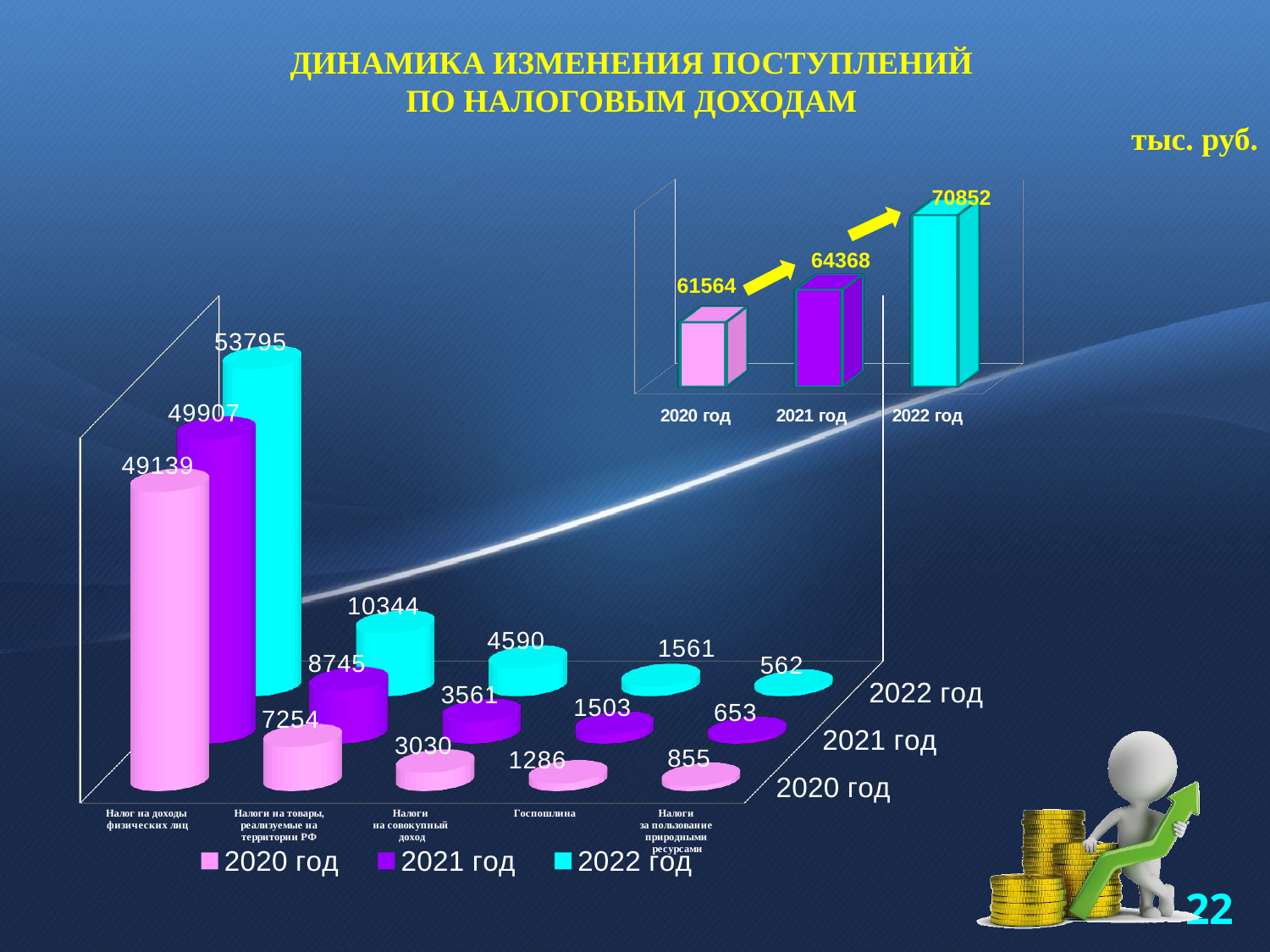
In the large chart at the bottom left of the slide, do the values for Налоги за пользование природными ресурсами rise or fall from 2020 год to 2022 год? fall In the large chart at the bottom left of the slide, which category has the lowest 2022 год value? Налоги за пользование природными ресурсами In the large chart at the bottom left of the slide, how many series does the legend list? 3 In the large chart at the bottom left of the slide, what is the 2020 год value for Госпошлина? 1286 In the large chart at the bottom left of the slide, what is the difference between the 2022 год and 2020 год values for Налоги на товары, реализуемые на территории РФ? 3090 In the small chart at the top right of the slide, do the values rise or fall from 2020 год to 2022 год? rise In the large chart at the bottom left of the slide, which category has the highest 2020 год value? Налог на доходы физических лиц In the large chart at the bottom left of the slide, what is the 2022 год value for Налог на доходы физических лиц? 53795 In the large chart at the bottom left of the slide, what is the 2021 год value for Налоги на совокупный доход? 3561 In the small chart at the top right of the slide, what is the difference between the 2022 год and 2021 год values? 6484 In the small chart at the top right of the slide, what is the value for 2022 год? 70852 In the small chart at the top right of the slide, what is the value for 2020 год? 61564